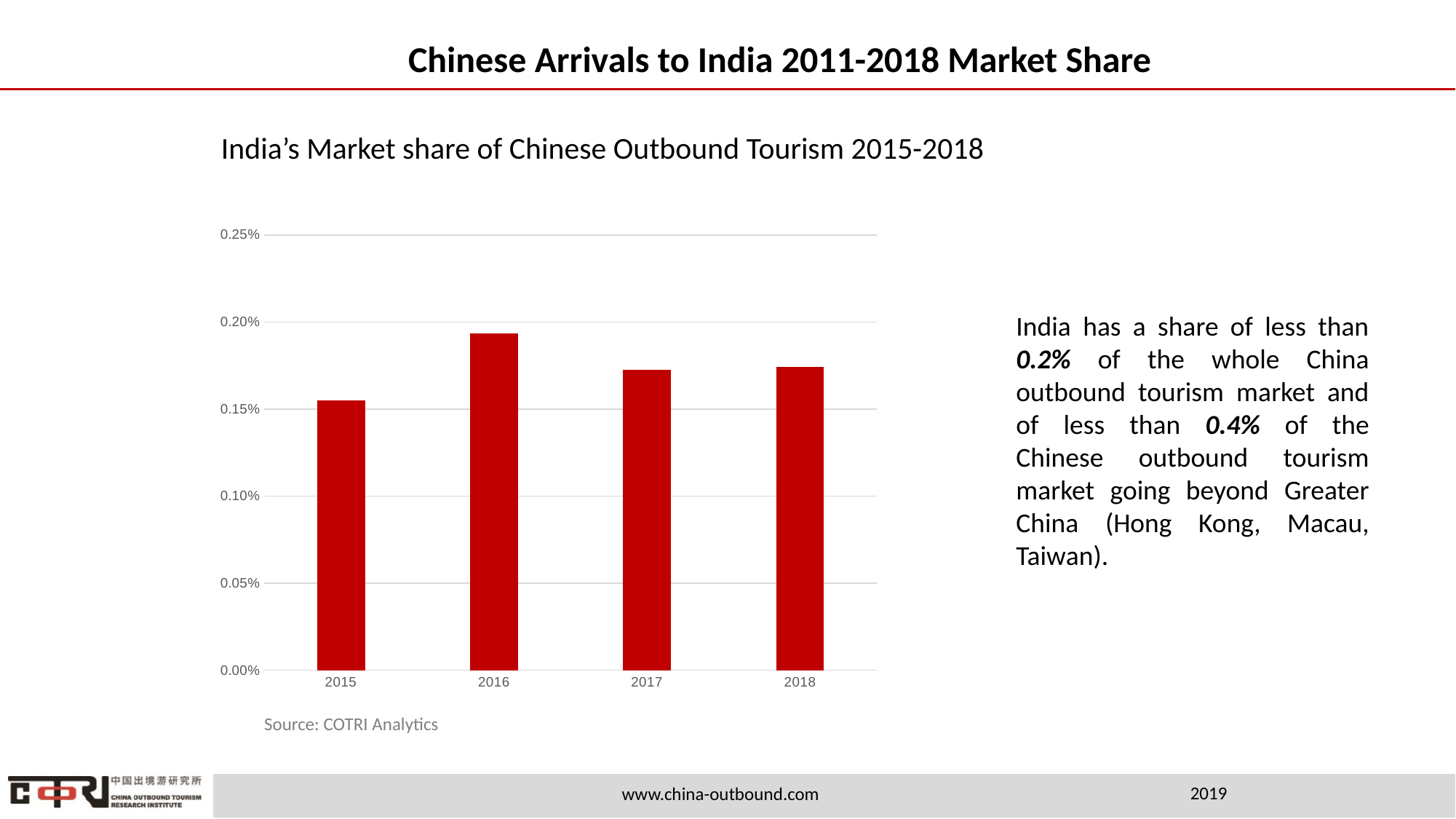
How many years are shown on the x axis of the chart? 4 Which year has the highest market share in the chart? 2016 What kind of chart is shown on the slide? bar chart Is the value for 2017 greater or less than 0.15%? greater Is the value for 2016 greater or less than 0.20%? less Which year has the lowest market share in the chart? 2015 What is the title of the chart? India's Market share of Chinese Outbound Tourism 2015-2018 What source is cited below the chart? COTRI Analytics Is the value for 2016 greater or less than 0.15%? greater Which is larger, the value for 2015 or the value for 2016? 2016 Does the market share rise or fall from 2016 to 2017? fall